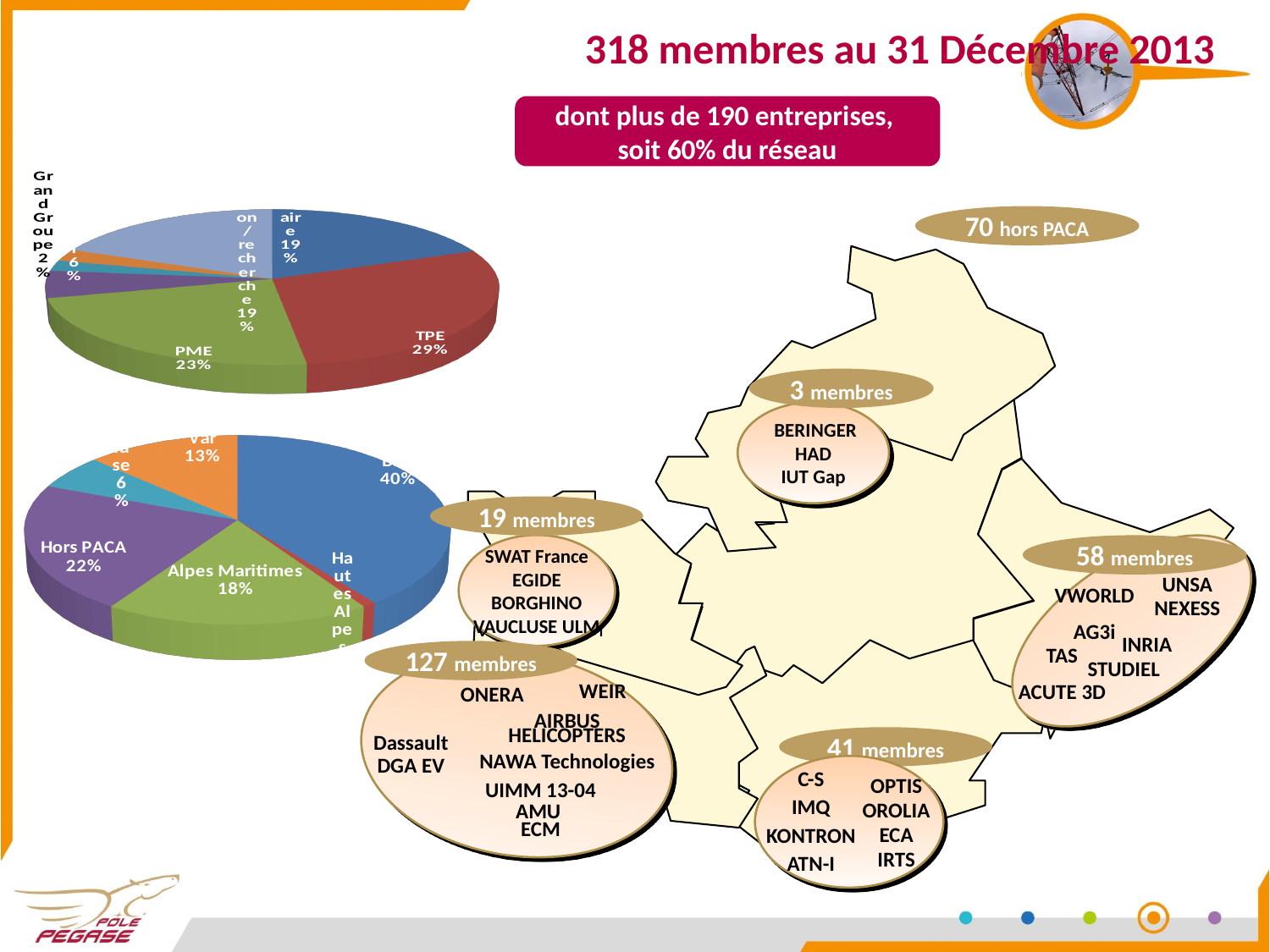
In the lower pie chart on the left, which is larger, Hors PACA or Alpes Maritimes? Hors PACA In the lower pie chart on the left, what share is labelled for Alpes Maritimes? 18% In the lower pie chart on the left, what share is labelled for Var? 13% In the upper pie chart on the left, what share is labelled for TPE? 29% In the lower pie chart on the left, what share is labelled for Hors PACA? 22% What kind of chart is the upper chart on the left of the slide? Pie chart In the upper pie chart on the left, how many percentage points larger is TPE than PME? 6% In the lower pie chart on the left, how many percentage points larger is Hors PACA than Var? 9% In the upper pie chart on the left, what share is labelled for PME? 23% In the upper pie chart on the left, which labelled category has the smallest share? Grand Groupe In the upper pie chart on the left, what share is labelled for Grand Groupe? 2% In the upper pie chart on the left, which labelled category has the largest share? TPE